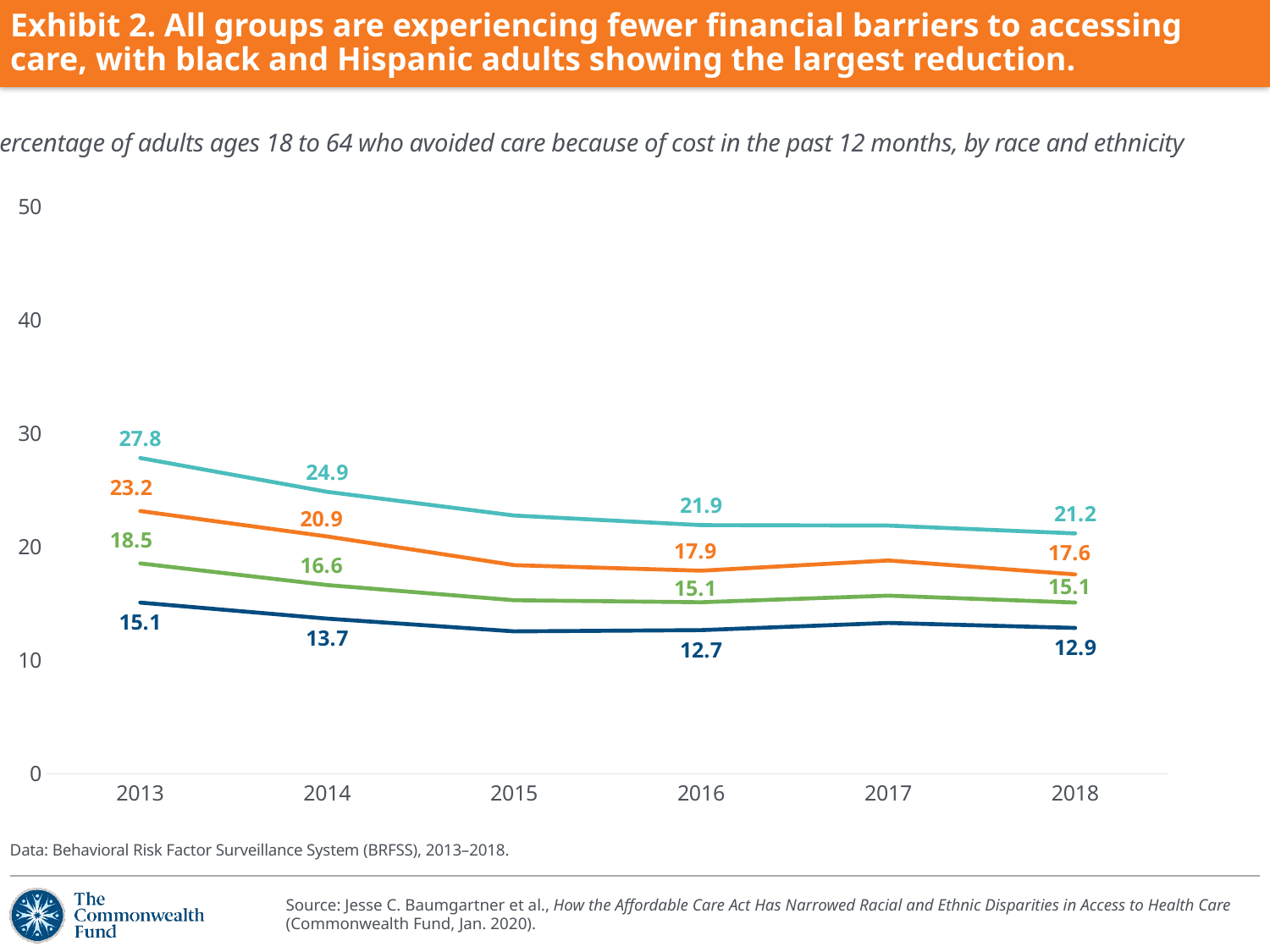
Which line has the lowest value in 2018? the dark blue line (12.9) Is the value of the teal line in 2015 greater or less than 20? greater What is the difference between the teal line's value in 2013 and its value in 2018? 6.6 Which line has the highest value in 2013? the teal line (27.8) What is the value of the green line in 2018? 15.1 Does the teal line generally rise or fall from 2013 to 2018? fall What is the value of the teal (top) line in 2013? 27.8 What is the value of the dark blue (bottom) line in 2014? 13.7 Which is larger: the orange line's value in 2014 or the green line's value in 2013? the orange line's value in 2014 (20.9) What type of chart is shown on the slide? line chart What is the value of the orange line in 2016? 17.9 How many years are shown along the x axis? 6